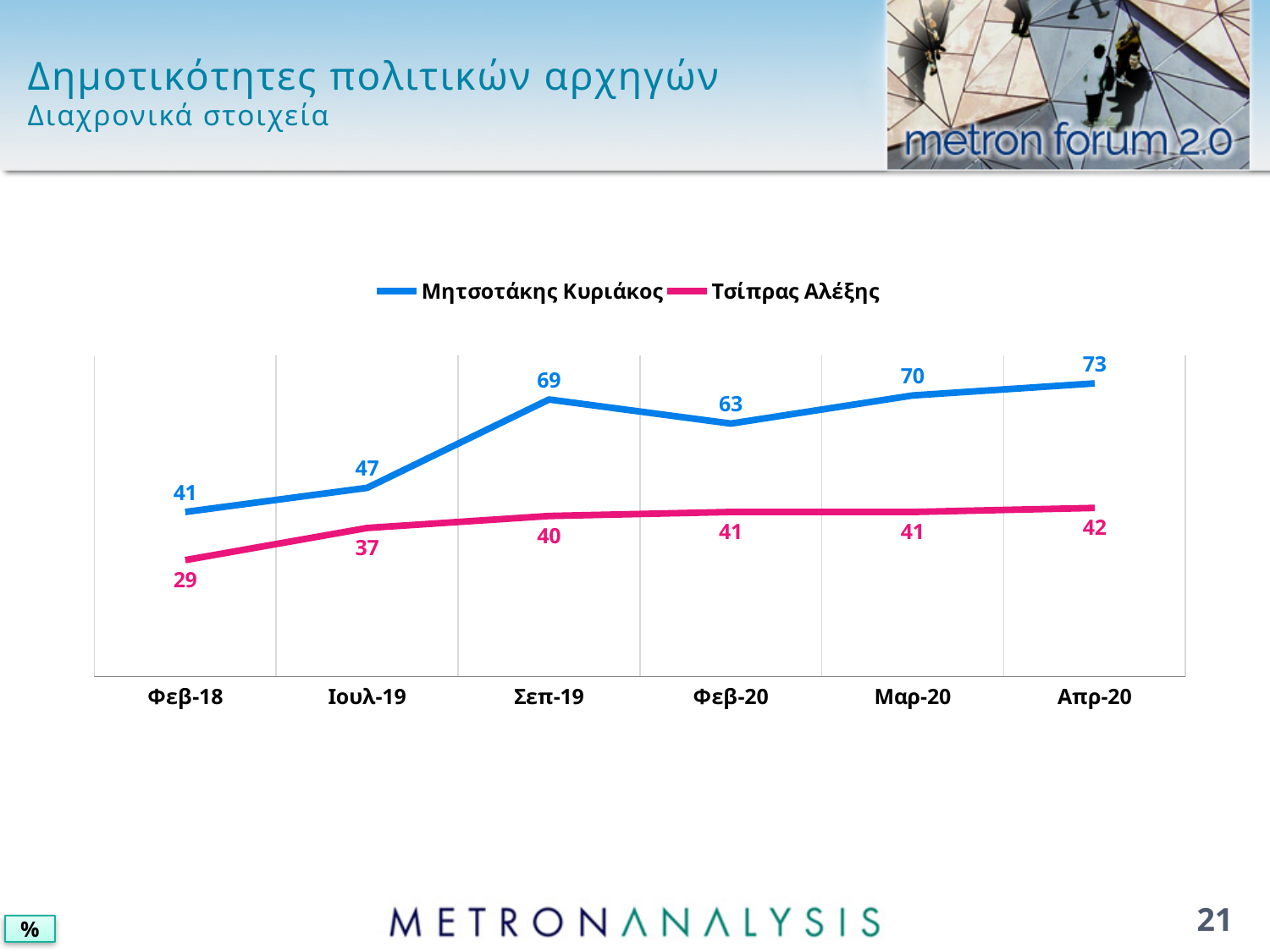
In which period is the value for Μητσοτάκης Κυριάκος highest? Απρ-20 How many time periods are shown on the x axis? 6 What is the value for Μητσοτάκης Κυριάκος in Απρ-20? 73 What is the value for Μητσοτάκης Κυριάκος in Σεπ-19? 69 What is the value for Τσίπρας Αλέξης in Ιουλ-19? 37 What kind of chart is shown on the slide? Line chart What is the value for Τσίπρας Αλέξης in Φεβ-18? 29 Does the value for Τσίπρας Αλέξης rise or fall from Φεβ-18 to Απρ-20? Rise What is the difference between Μητσοτάκης Κυριάκος and Τσίπρας Αλέξης in Απρ-20? 31 Which series has the higher value in Φεβ-20, Μητσοτάκης Κυριάκος or Τσίπρας Αλέξης? Μητσοτάκης Κυριάκος In which period is the value for Τσίπρας Αλέξης lowest? Φεβ-18 How many series does the legend list? 2